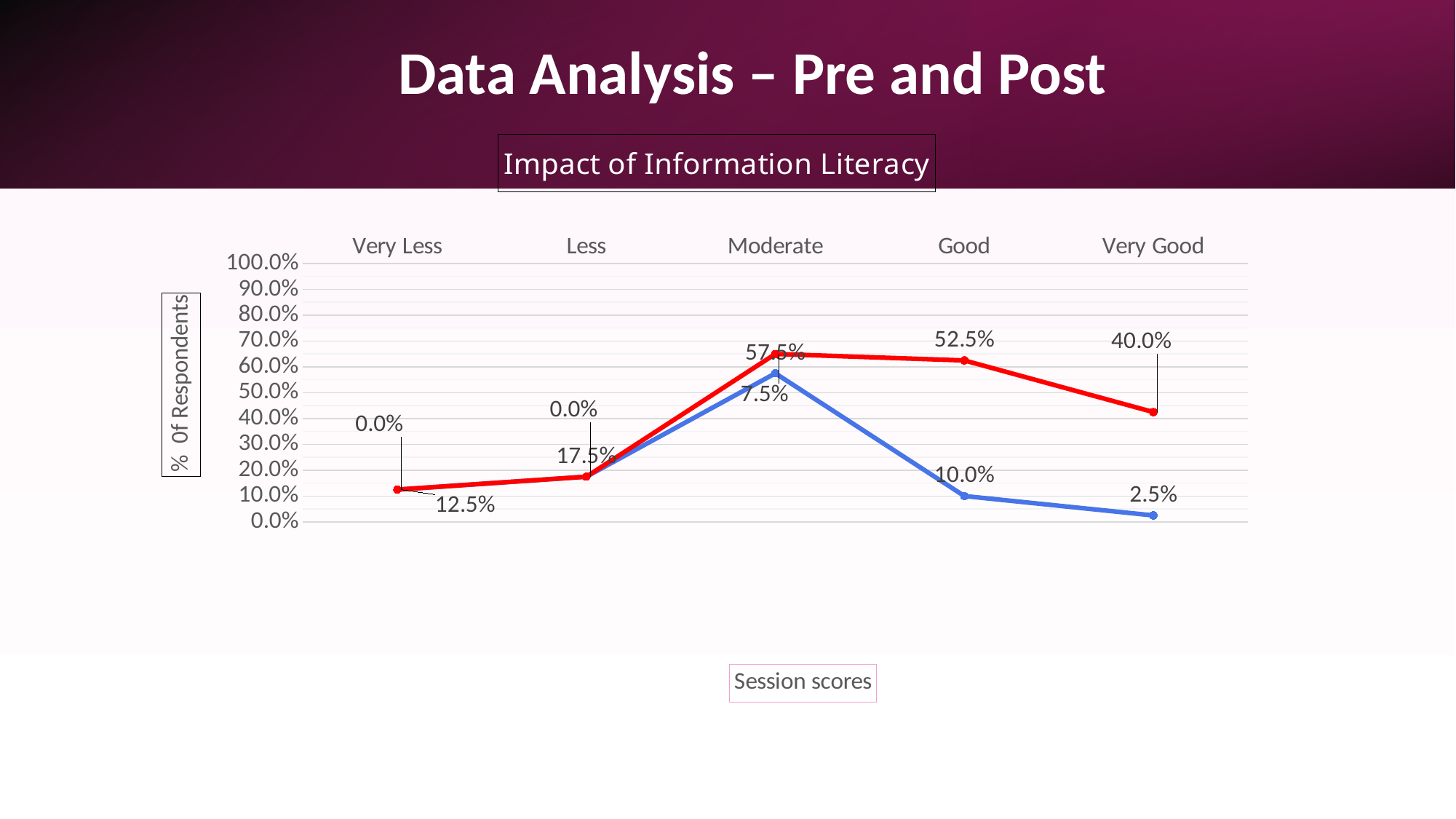
Which line has the larger value at Good, the red line or the blue line? red line What is the value of the red line at Less? 0.0% What is the label on the vertical axis of the chart? % Of Respondents At which category does the blue line have its lowest value? Very Good What kind of chart is shown on the slide? line chart What is the title of the chart? Impact of Information Literacy What is the value of the blue line at Good? 10.0% At which category does the blue line reach its highest value? Moderate What is the value of the red line at Very Less? 0.0% What is the value of the blue line at Very Good? 2.5% How many categories are shown along the x axis of the chart? 5